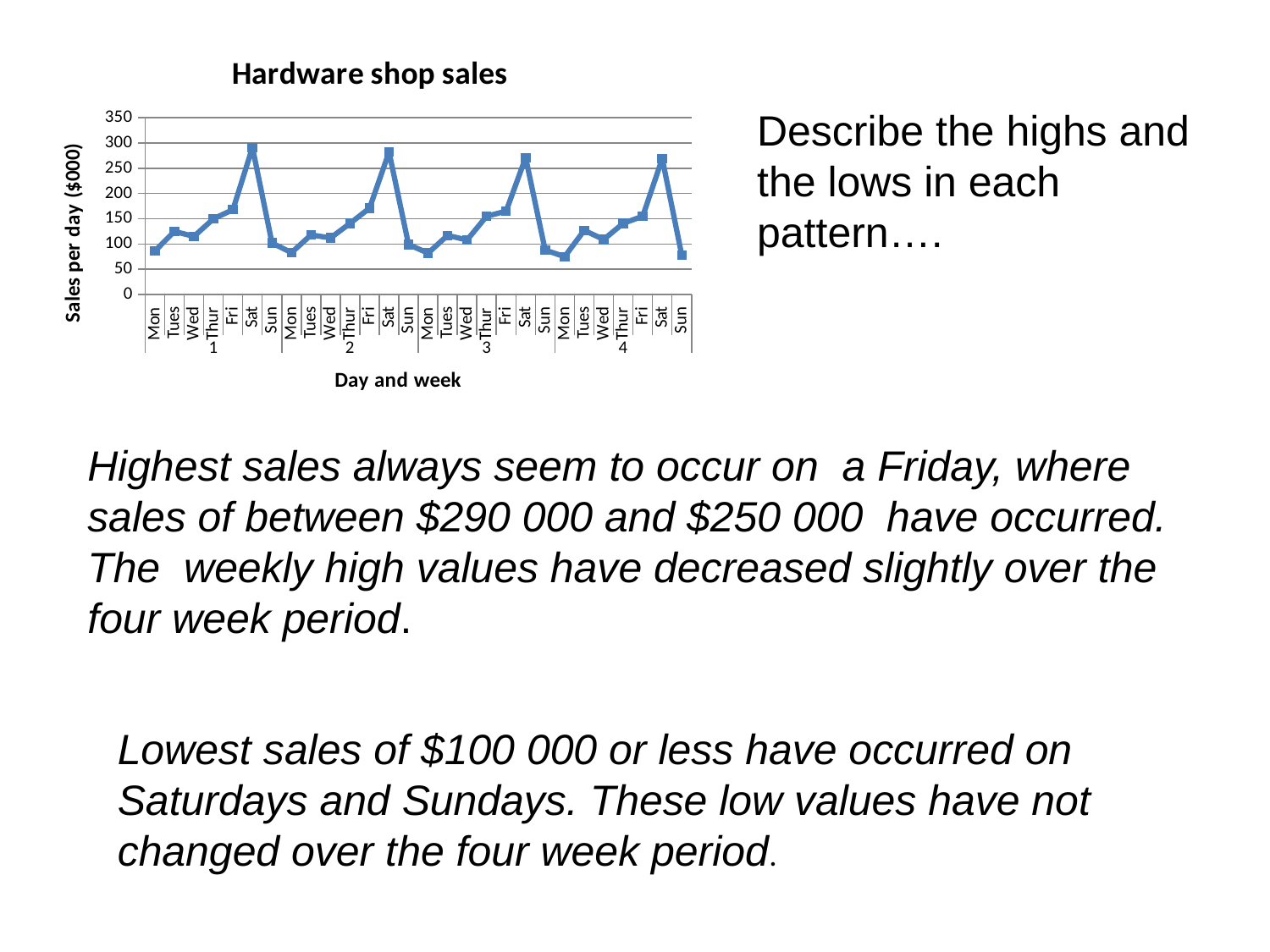
How many data points are plotted on the chart? 28 What is the label on the vertical axis of the chart? Sales per day ($000) Which is larger, the value for Sat in week 1 or the value for Sun in week 1? Sat in week 1 Is the value for Mon in week 1 greater or less than 100? less Do the values rise or fall from Mon to Sat in week 1? rise Is the value for Sat in week 1 greater or less than 250? greater Is the value for Sat in week 4 greater or less than 200? greater What kind of chart is shown on the slide? line chart What is the title of the chart? Hardware shop sales How many weeks are shown along the x axis of the chart? 4 Which day in week 1 has the highest value on the chart? Sat